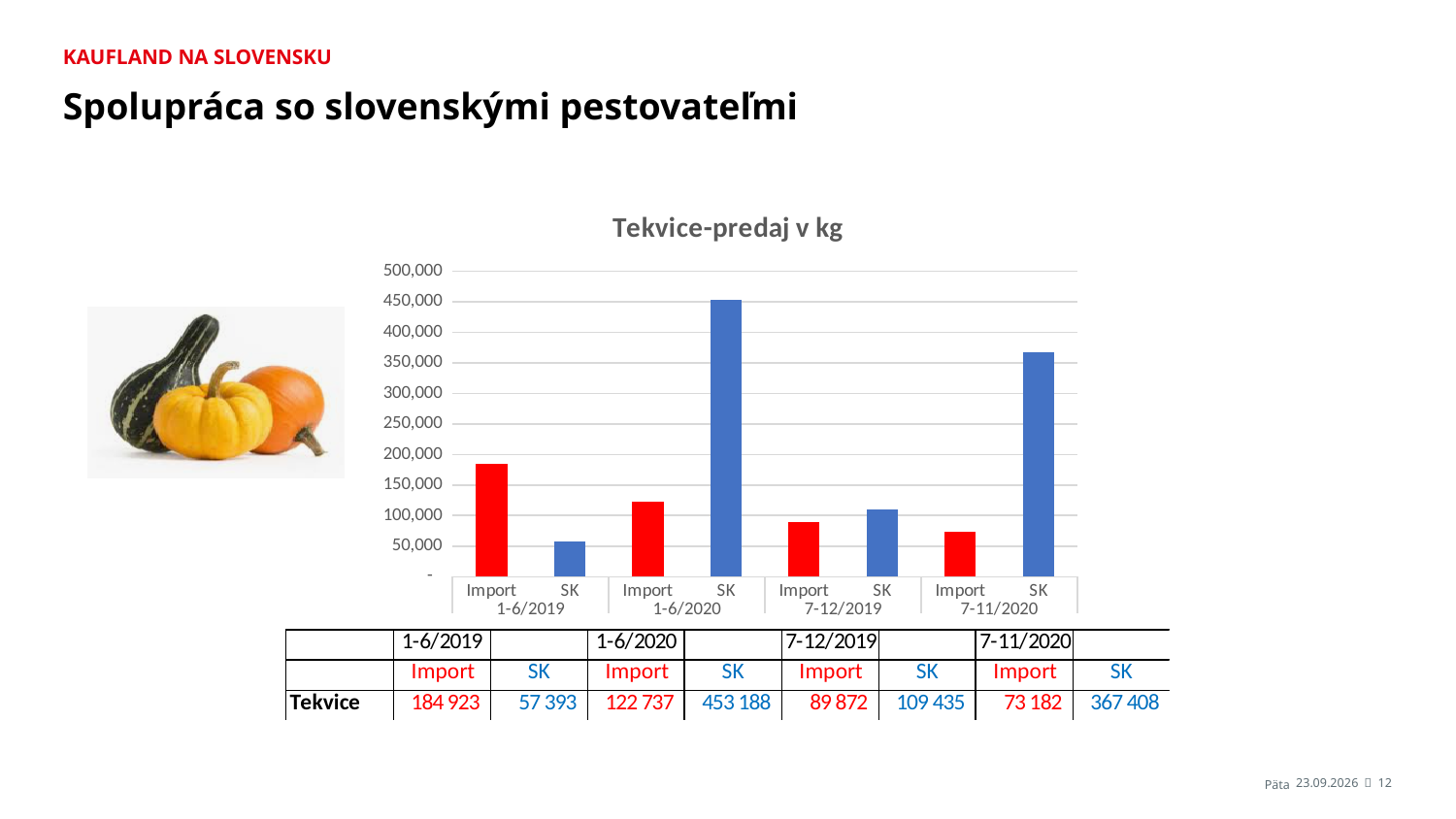
What kind of chart is shown on the slide? bar chart What is the difference between SK and Import in the period 1-6/2020? 330 451 What is the value for Import in the period 1-6/2019? 184 923 Which is larger in the period 7-12/2019, Import or SK? SK Is the value for SK in 7-11/2020 greater or less than 350,000? greater What is the value for SK in the period 7-11/2020? 367 408 Which bar has the highest value in the chart? SK 1-6/2020 What is the value for Import in the period 7-12/2019? 89 872 How many bars are plotted in the chart? 8 Which bar has the lowest value in the chart? SK 1-6/2019 What is the value for SK in the period 1-6/2020? 453 188 What is the title of the chart? Tekvice-predaj v kg